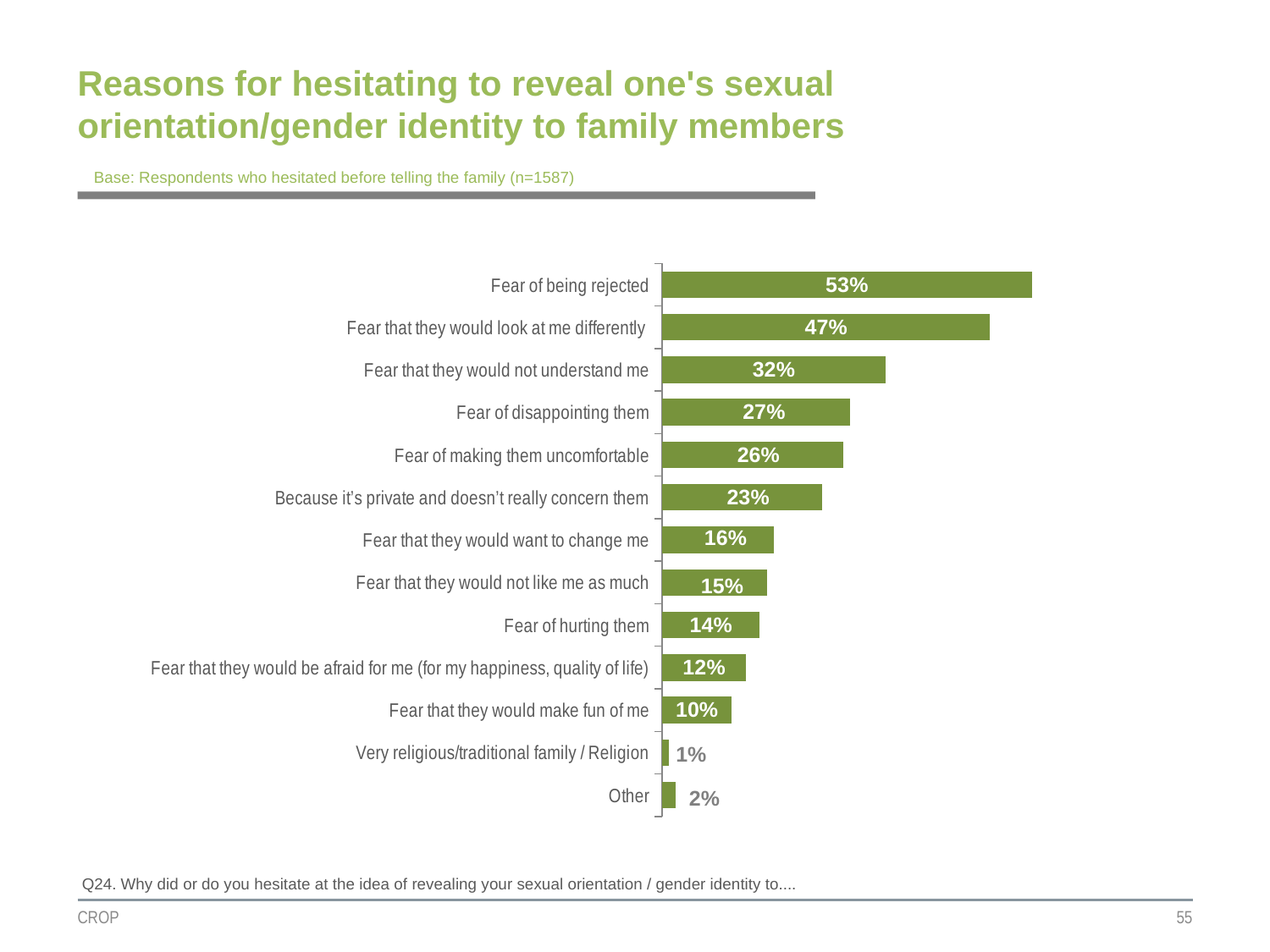
What percentage of respondents cited "Fear of being rejected" as a reason for hesitating? 53% Which is larger: the value for "Fear of disappointing them" or the value for "Because it's private and doesn't really concern them"? Fear of disappointing them Which reason has the lowest percentage on the chart? Very religious/traditional family / Religion What is the value for "Fear that they would not understand me"? 32% Which reason has the highest percentage on the chart? Fear of being rejected What kind of chart is shown on the slide? Bar chart How many reasons (categories) are plotted on the chart? 13 What is the difference in percentage points between "Fear of hurting them" and "Fear that they would be afraid for me (for my happiness, quality of life)"? 2 What is the difference in percentage points between "Fear of being rejected" and "Fear that they would look at me differently"? 6 What is the base (sample size) stated for the chart? n=1587 What percentage is shown for "Fear that they would make fun of me"? 10% What colour are the bars on the chart? Green